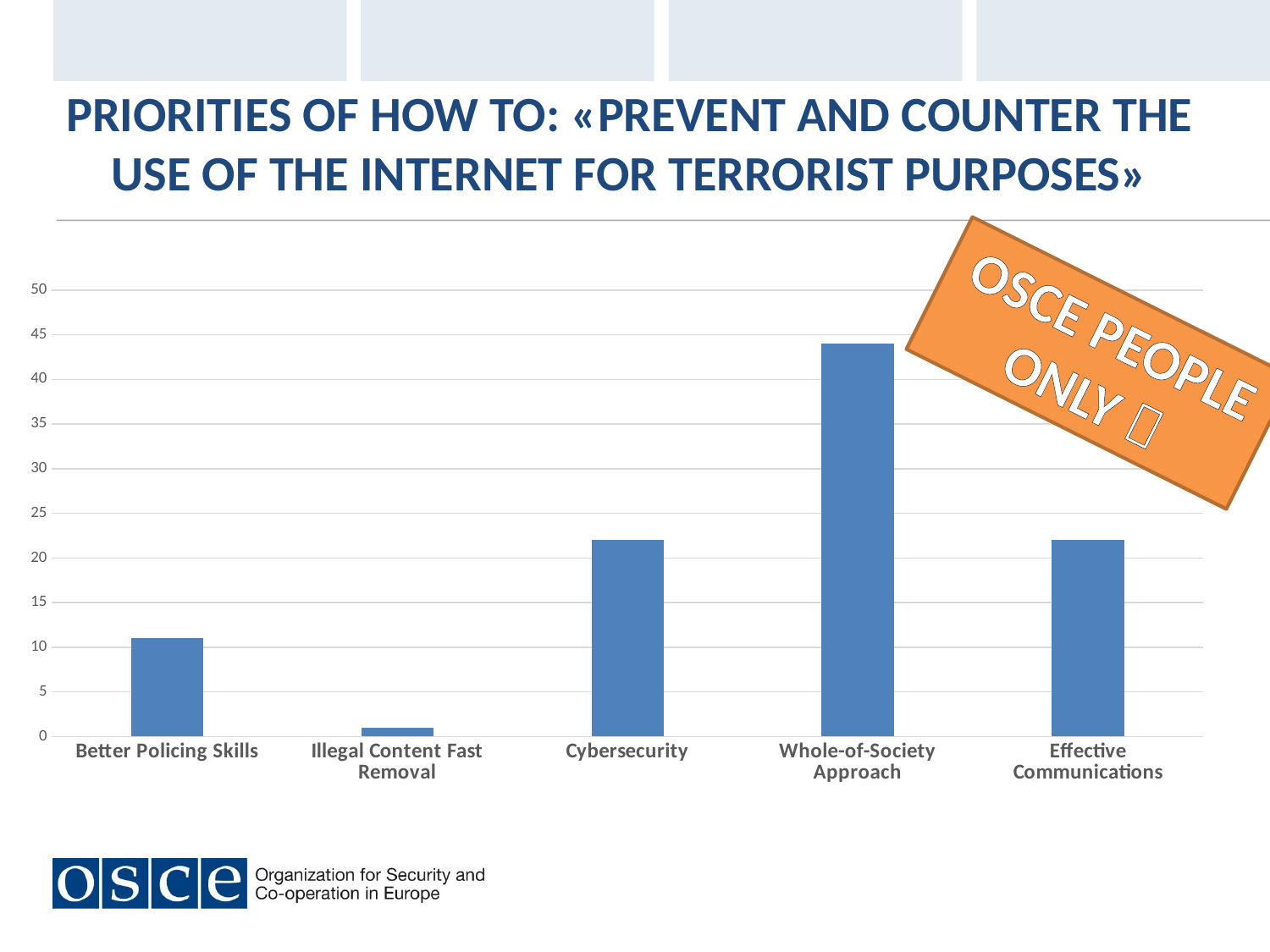
Is the value for Effective Communications greater or less than 25? less How many categories are shown on the x axis of the chart? 5 What kind of chart is shown on the slide? bar chart Is the value for Better Policing Skills greater or less than 15? less Is the value for Cybersecurity greater or less than 20? greater Which category has the lowest bar? Illegal Content Fast Removal Which is larger, the value for Better Policing Skills or the value for Cybersecurity? Cybersecurity Which category has the highest bar? Whole-of-Society Approach What is the highest value shown on the y axis of the chart? 50 Which is larger, the value for Whole-of-Society Approach or the value for Effective Communications? Whole-of-Society Approach